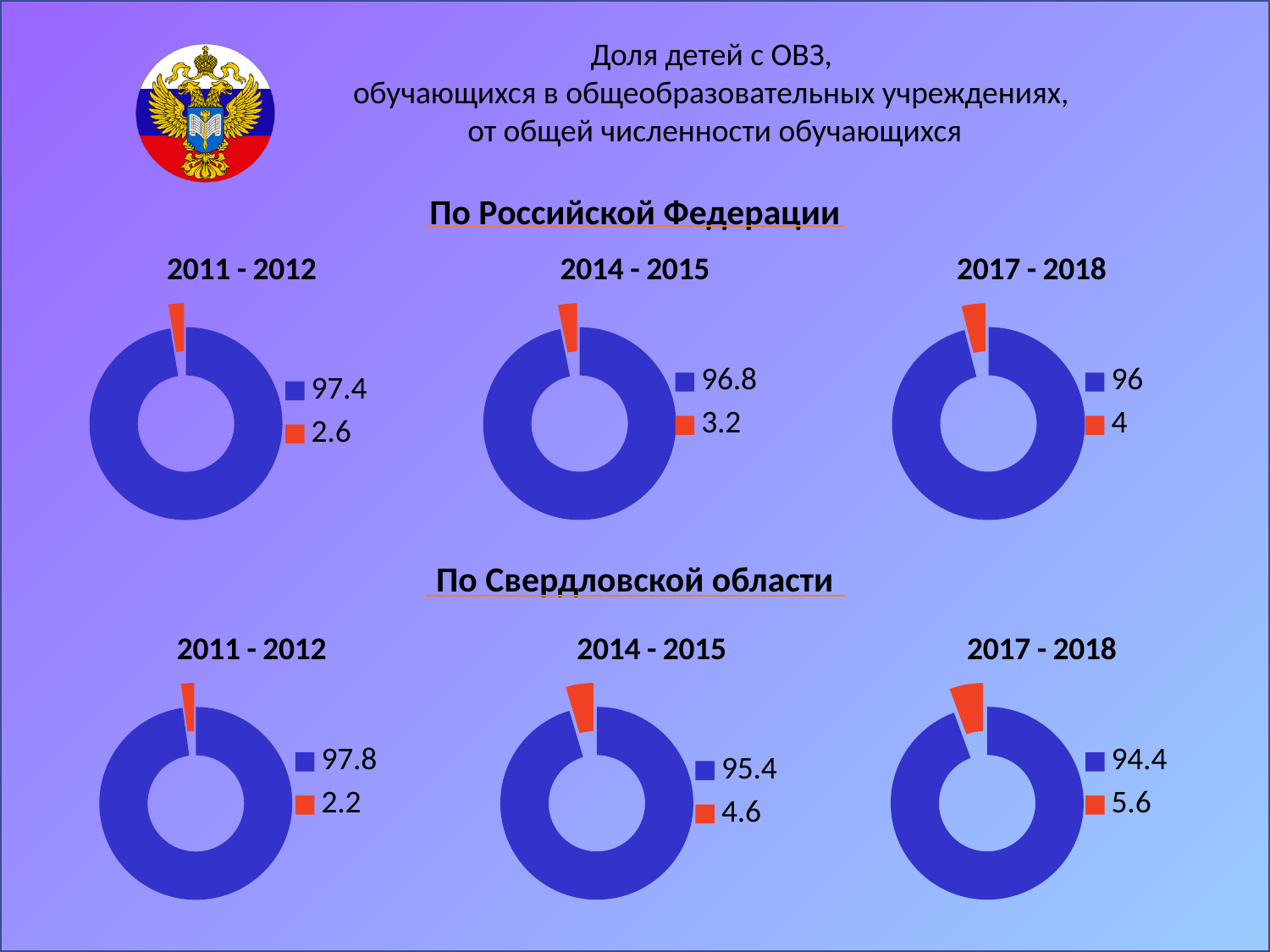
What is the heading above the bottom row of charts? По Свердловской области In the 2014 - 2015 chart under "По Свердловской области", what is the difference between the blue slice value and the red slice value? 90.8 In the 2017 - 2018 chart under "По Свердловской области", what value does the red slice represent? 5.6 What kind of chart is used for the 2011 - 2012 chart under "По Российской Федерации"? doughnut chart Which is larger: the red slice in the 2017 - 2018 chart under "По Свердловской области" or the red slice in the 2017 - 2018 chart under "По Российской Федерации"? По Свердловской области 2017 - 2018 In the 2014 - 2015 chart under "По Свердловской области", what value does the red slice represent? 4.6 In the 2011 - 2012 chart under "По Российской Федерации", what value does the red (orange) slice represent? 2.6 In the 2014 - 2015 chart under "По Российской Федерации", what value does the blue slice represent? 96.8 Across the three charts under "По Российской Федерации", does the red slice value rise or fall from 2011 - 2012 to 2017 - 2018? rise How many slices does the 2017 - 2018 chart under "По Свердловской области" have? 2 In the 2017 - 2018 chart under "По Российской Федерации", what value does the red slice represent? 4 In the 2011 - 2012 chart under "По Свердловской области", what value does the blue slice represent? 97.8